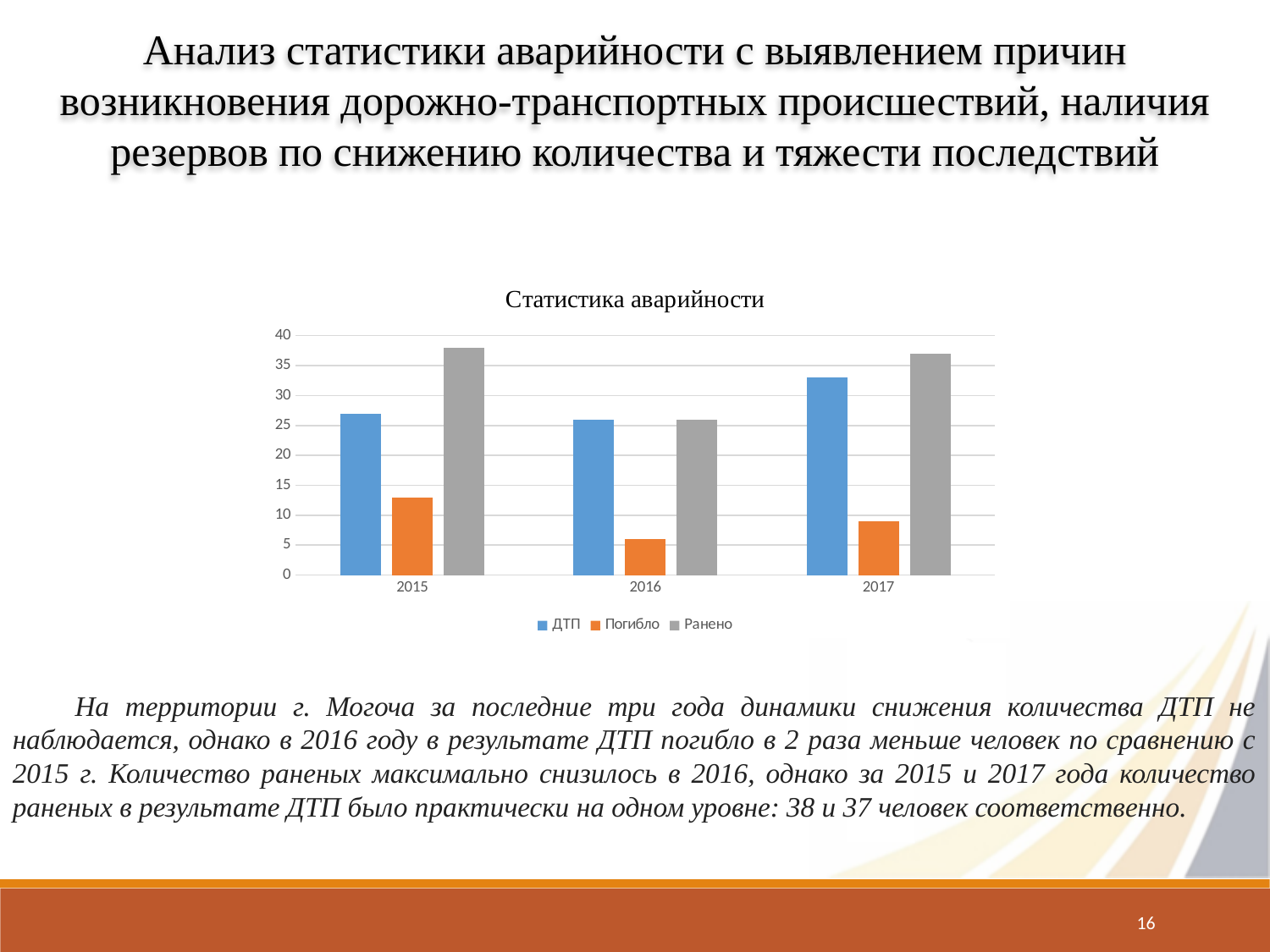
In which year is the Погибло value lowest? 2016 In 2015, which is larger: ДТП or Ранено? Ранено Is the value for Погибло in 2016 greater or less than 10? less Is the value for Ранено in 2015 greater or less than 35? greater In which year is the Погибло value highest? 2015 How many years are shown on the x axis of the chart? 3 Is the value for ДТП in 2017 greater or less than 30? greater What kind of chart is shown on the slide? bar chart How many series does the chart legend list? 3 What is the title of the chart? Статистика аварийности In which year is the ДТП value highest? 2017